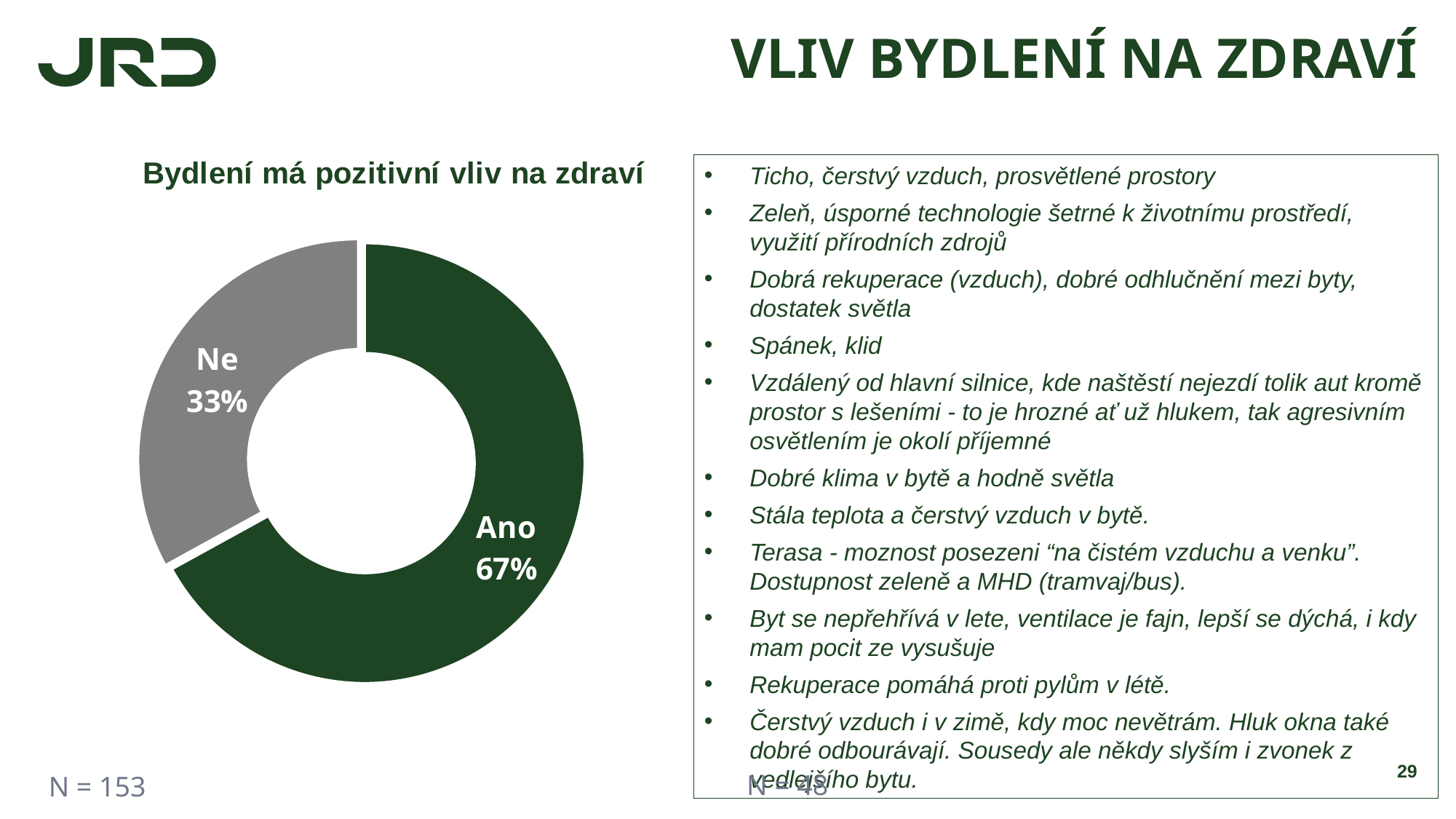
What is the sample size (N) shown below the chart? N = 153 What is the title of the chart? Bydlení má pozitivní vliv na zdraví Which category has the largest share in the chart? Ano What kind of chart is shown on the slide? Pie chart (doughnut) Which category has the smallest share in the chart? Ne How many categories are shown in the chart? 2 What percentage of respondents answered "Ano" in the chart "Bydlení má pozitivní vliv na zdraví"? 67% Which is larger, the share for "Ano" or the share for "Ne"? Ano What colour is the "Ano" slice of the chart? Dark green What percentage of respondents answered "Ne" in the chart? 33% What is the difference in percentage points between the "Ano" and "Ne" shares? 34